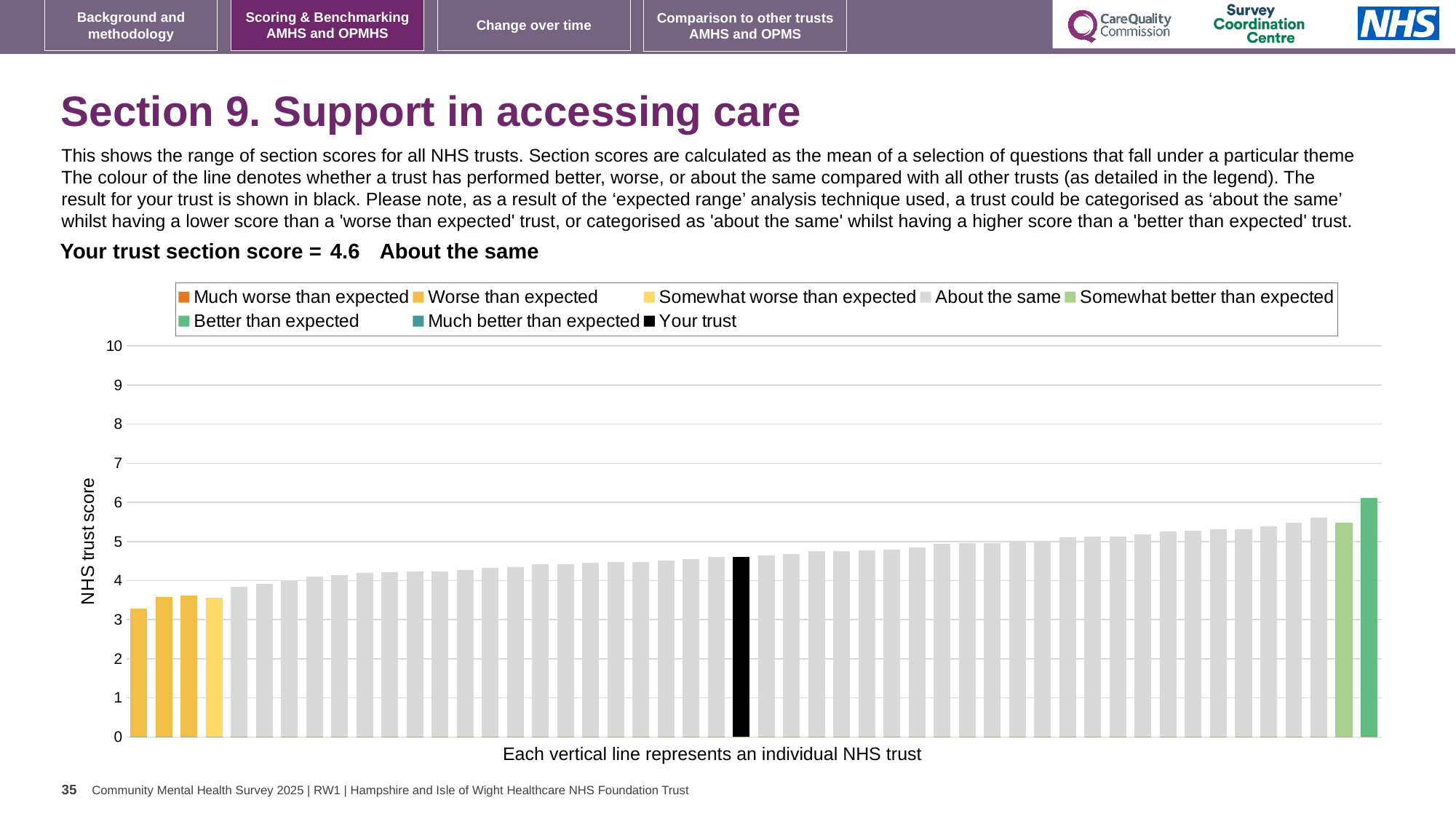
Is the value of the tallest bar (rightmost) greater or less than 5? greater What is the section score for your trust? 4.6 How many entries does the chart legend list? 8 Is the value of the shortest bar (leftmost) greater or less than 4? less Which category is your trust's section score placed in? About the same How many bars are coloured as 'Worse than expected' (yellow)? 3 What is the label on the vertical axis of the chart? NHS trust score Do the bar values rise or fall from left to right along the x axis? rise What kind of chart is shown on the slide? bar chart Is the value of the black 'Your trust' bar greater or less than 4? greater What colour is the bar representing your trust? black